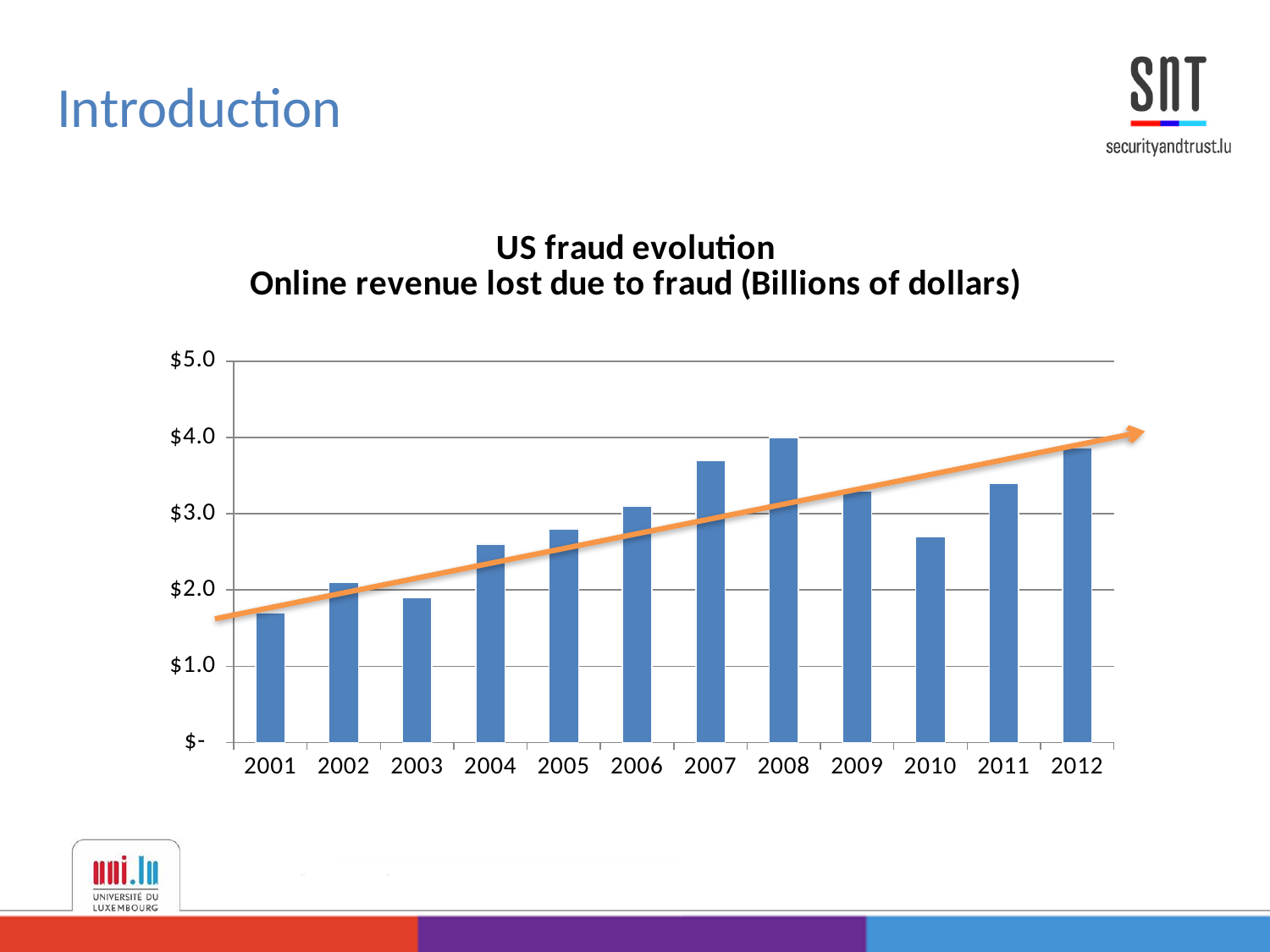
Do the values generally rise or fall from 2001 to 2012? rise How many years are shown on the x axis of the chart? 12 Which is larger, the value for 2008 or the value for 2009? 2008 Is the value for 2004 greater or less than $2.0? greater Is the value for 2010 greater or less than $3.0? less Which year has the highest online revenue lost due to fraud? 2008 What is the title of the chart? US fraud evolution Online revenue lost due to fraud (Billions of dollars) Is the value for 2001 greater or less than $2.0? less What is the value for 2008? $4.0 What kind of chart is shown on the slide? bar chart Which year has the lowest online revenue lost due to fraud? 2001